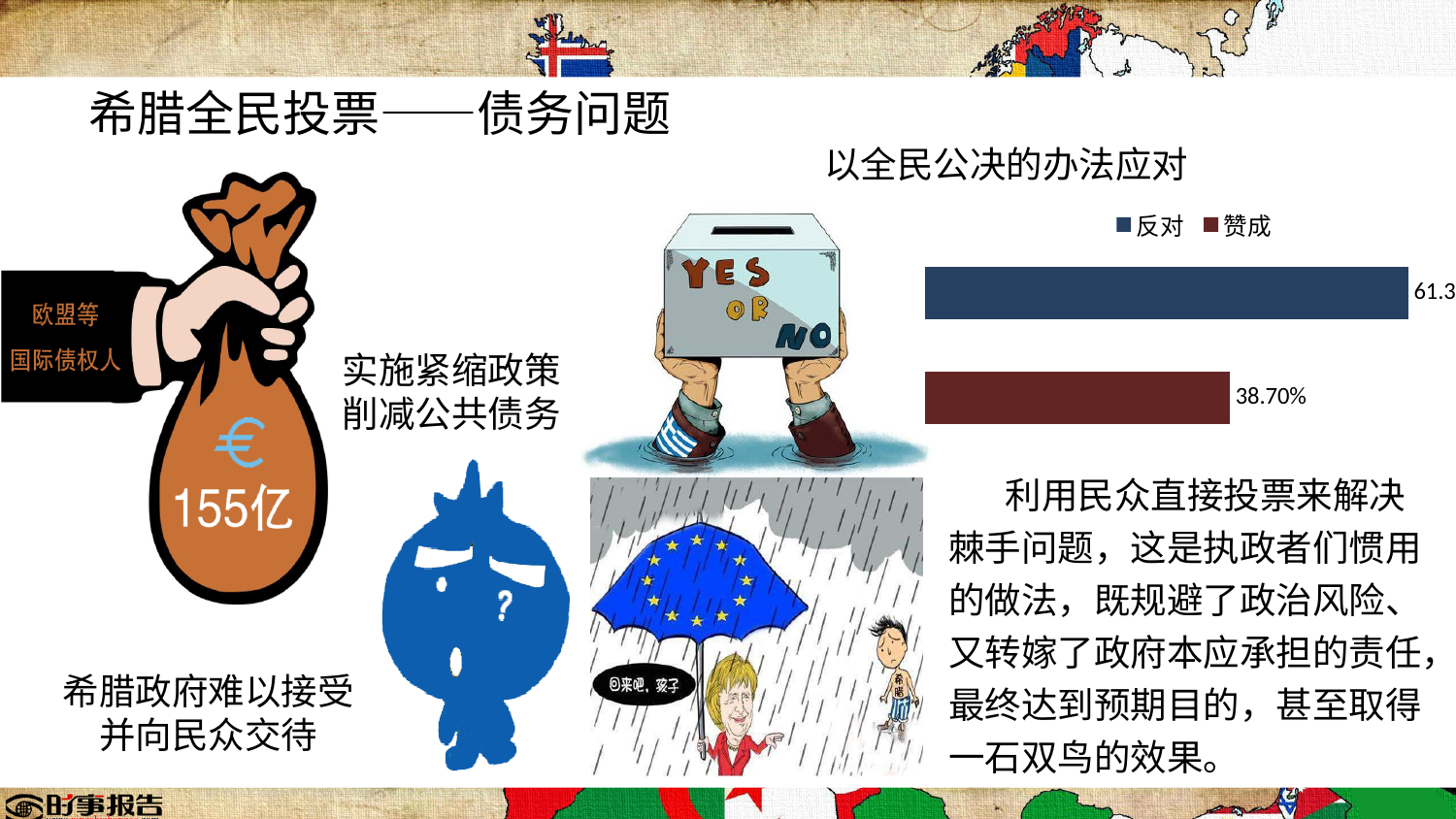
Which category has the lowest value in the bar chart? 赞成 How many entries does the chart legend list? 2 What colour is the bar for 反对? dark blue What kind of chart is shown on the slide? bar chart Which category has the longer bar in the chart, 反对 or 赞成? 反对 What value is shown for 赞成 in the bar chart? 38.70% Which category has the highest value in the bar chart? 反对 How many bars are plotted in the chart? 2 What colour is the bar for 赞成? dark red